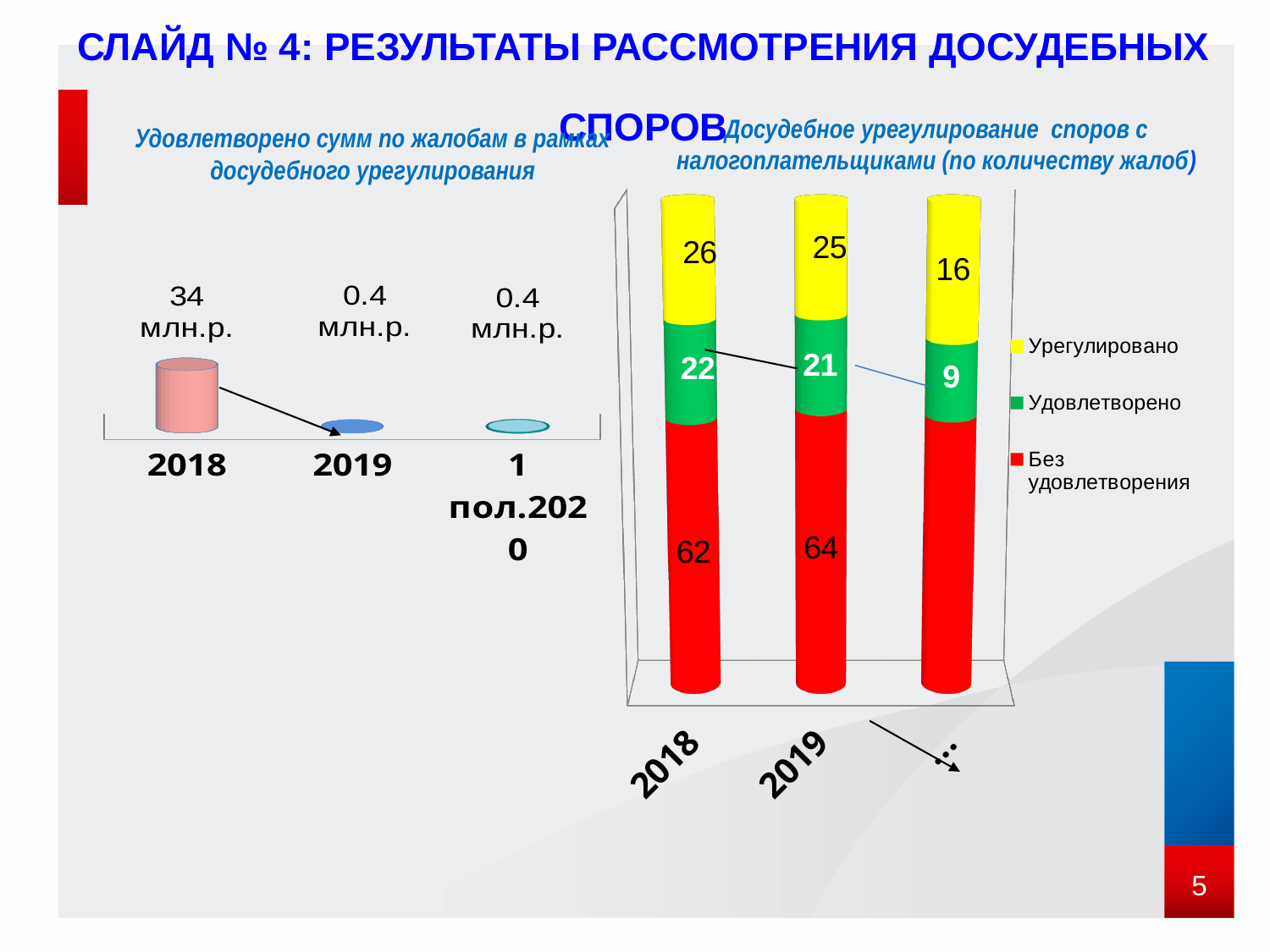
On the right chart (Досудебное урегулирование споров), what is the value of Без удовлетворения for 2018? 62 On the right chart (Досудебное урегулирование споров), how many series does the legend list? 3 On the right chart (Досудебное урегулирование споров), what is the difference between Без удовлетворения for 2019 and for 2018? 2 On the right chart (Досудебное урегулирование споров), what is the total of the stacked bar for 2018? 110 On the left chart (Удовлетворено сумм по жалобам), what is the value for 2018? 34 млн.р. On the right chart (Досудебное урегулирование споров), what is the value of Урегулировано for 2019? 25 On the right chart (Досудебное урегулирование споров), what is the value of Удовлетворено for 2019? 21 On the left chart (Удовлетворено сумм по жалобам), which category has the highest value? 2018 What kind of chart is the right chart (Досудебное урегулирование споров)? Stacked bar chart On the left chart (Удовлетворено сумм по жалобам), how many categories are shown? 3 On the left chart (Удовлетворено сумм по жалобам), what is the value for 2019? 0.4 млн.р. On the right chart (Досудебное урегулирование споров), which is larger: Урегулировано for 2018 or Урегулировано for 2019? 2018